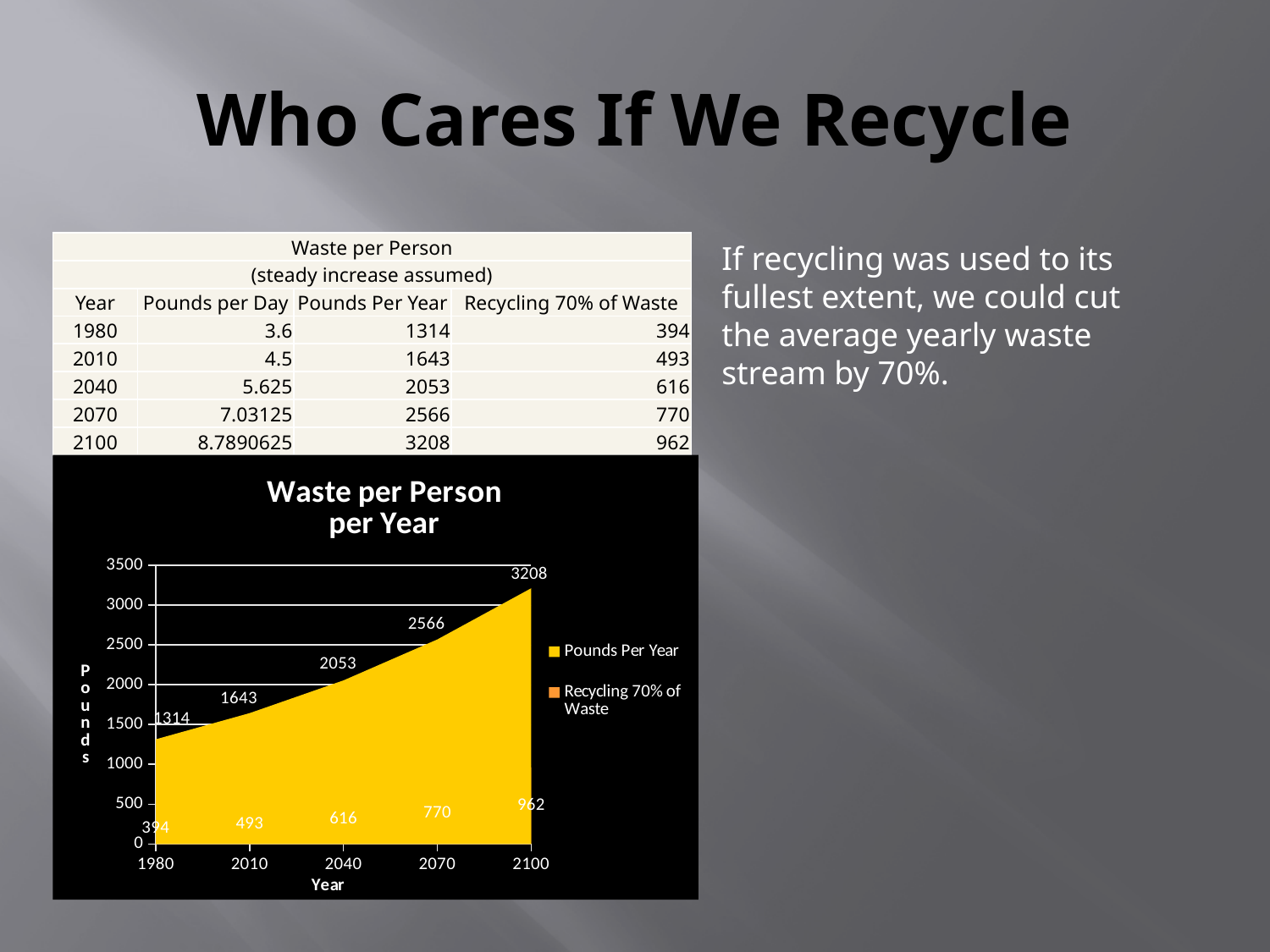
Which year has the lowest Recycling 70% of Waste value in the chart? 1980 What kind of chart is shown on the slide? area chart Do the Pounds Per Year values rise or fall from 1980 to 2100? rise How many series does the chart legend list? 2 What is the difference between the Pounds Per Year values for 2100 and 1980? 1894 How many years are plotted along the x axis of the chart? 5 What is the difference between the Pounds Per Year and Recycling 70% of Waste values for 2010? 1150 What is the Pounds Per Year value for 1980 in the chart? 1314 Which year has the highest Pounds Per Year value in the chart? 2100 What is the Pounds Per Year value for 2040 in the chart? 2053 Which is larger: the Pounds Per Year value for 2070 or for 2040? 2070 What is the Recycling 70% of Waste value for 2070 in the chart? 770